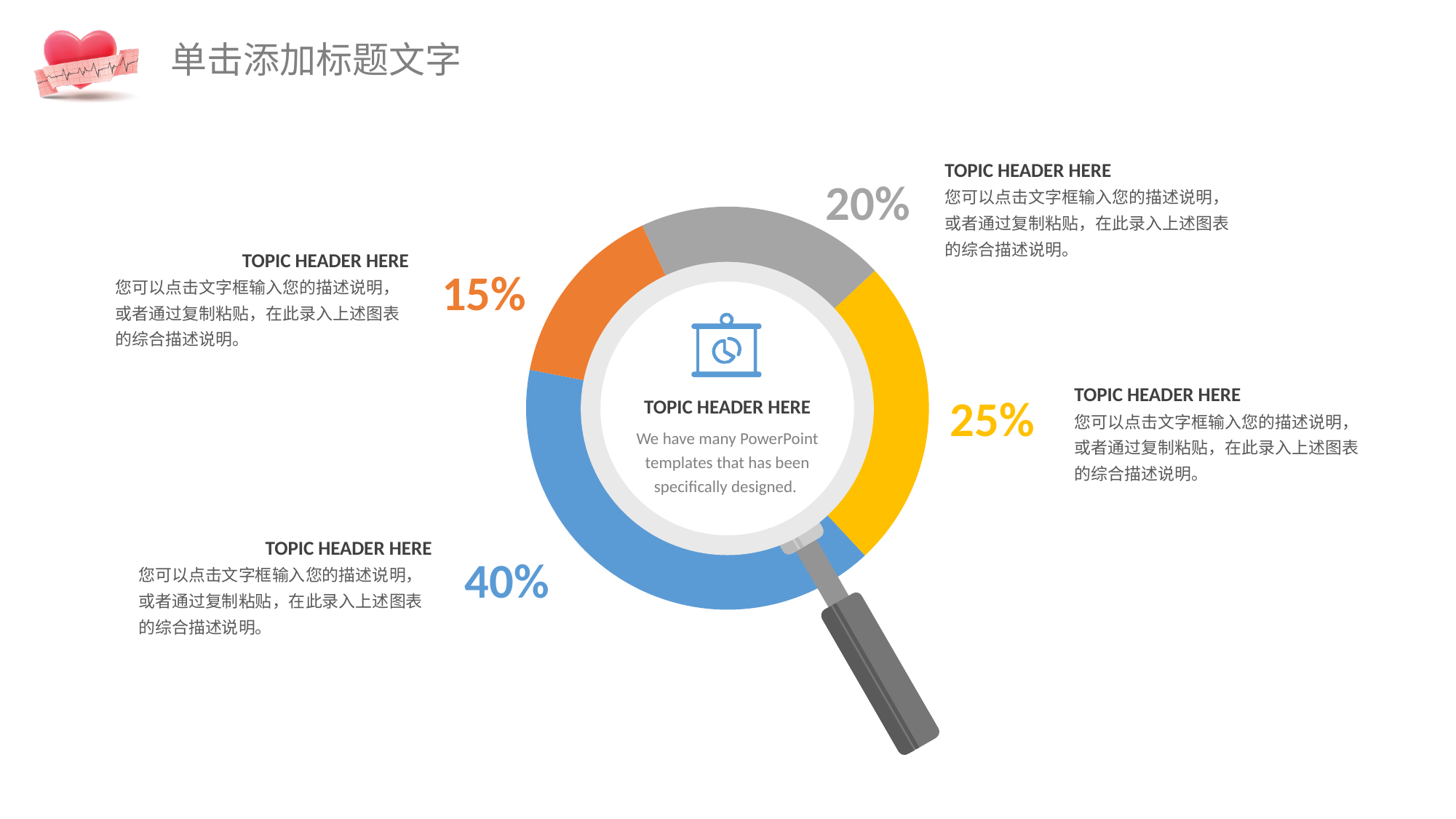
Which is larger, the gray segment or the orange segment? Gray What percentage is shown for the blue segment of the donut chart? 40% How many segments does the donut chart have? 4 What kind of chart is shown on the slide? Donut chart What is the total of the four percentages shown on the donut chart? 100% What percentage is shown for the gray segment of the donut chart? 20% What is the difference between the blue segment's percentage and the yellow segment's percentage? 15% Which colour segment of the donut chart has the smallest share? Orange What percentage is shown for the orange segment of the donut chart? 15% What colour is the segment labelled 25%? Yellow Which colour segment of the donut chart has the largest share? Blue What percentage is shown for the yellow segment of the donut chart? 25%